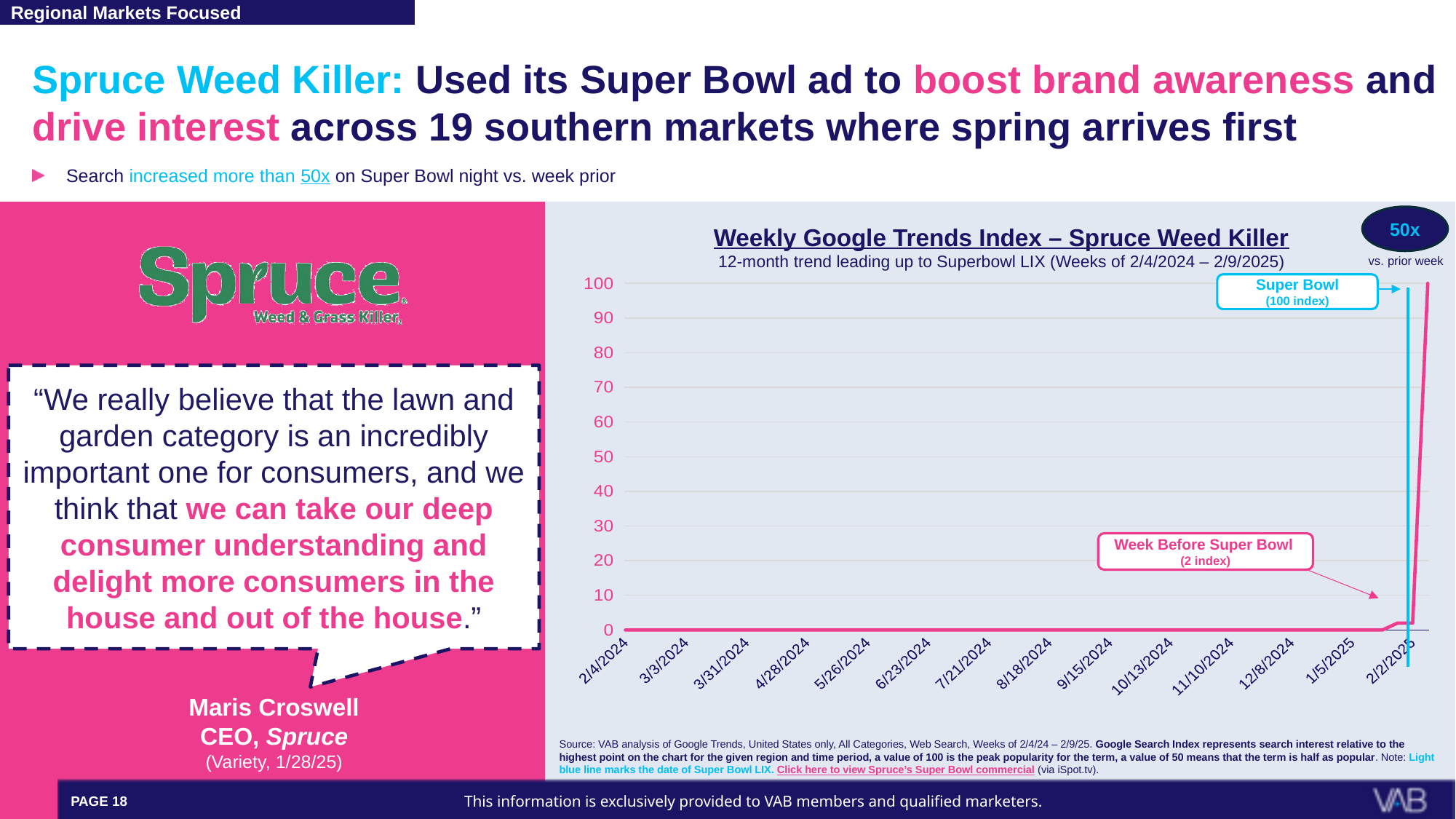
What is the Google Trends index value for the week before the Super Bowl? 2 What kind of chart is shown on the slide? Line chart What is the difference between the Super Bowl week index and the week-before-Super-Bowl index? 98 Is the index value for the week of 10/13/2024 greater or less than 20? less How many date labels are shown on the x axis? 14 What is the Google Trends index value for the Super Bowl week? 100 How does the index change across the x axis from 2/4/2024 to the Super Bowl week? Stays flat near 0, then spikes sharply to 100 at the end Which is larger, the index for the Super Bowl week or the index for the week before the Super Bowl? Super Bowl week What does the light blue vertical line on the chart mark? The date of Super Bowl LIX What is the title of the chart? Weekly Google Trends Index – Spruce Weed Killer Is the index value for the week of 6/23/2024 greater or less than 10? less Which week has the highest index value on the chart? Super Bowl week